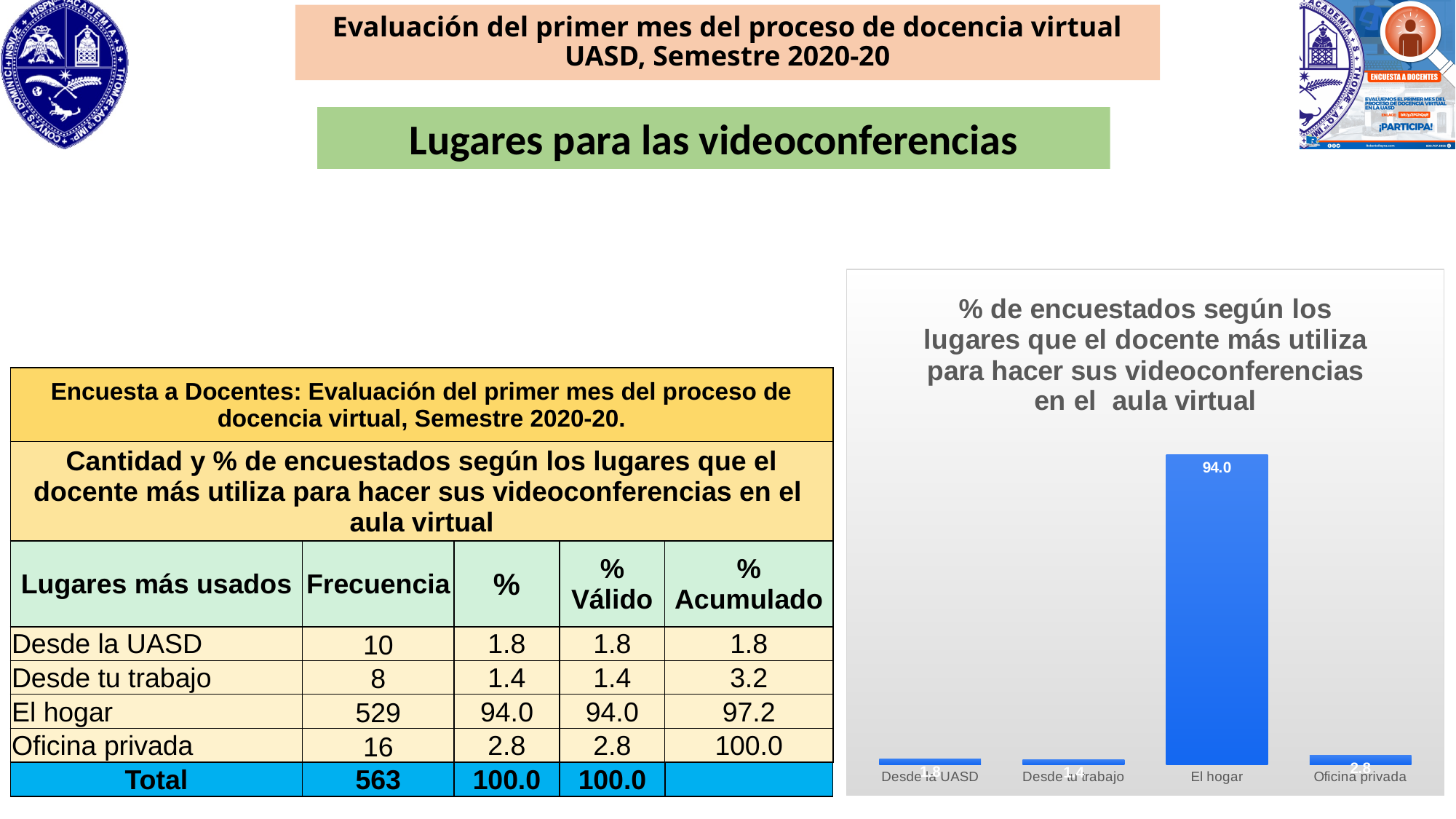
Which is larger in the bar chart, El hogar or Oficina privada? El hogar How many categories are shown in the bar chart? 4 What is the difference between the values for El hogar and Oficina privada in the bar chart? 91.2 Which category has the lowest value in the bar chart? Desde tu trabajo What is the value for Oficina privada in the bar chart? 2.8 What is the value for El hogar in the bar chart? 94.0 What is the value for Desde tu trabajo in the bar chart? 1.4 What is the difference between the values for Oficina privada and Desde la UASD in the bar chart? 1.0 What colour are the bars in the chart? blue What is the value for Desde la UASD in the bar chart? 1.8 Which category has the highest value in the bar chart? El hogar What kind of chart is shown on the slide? bar chart